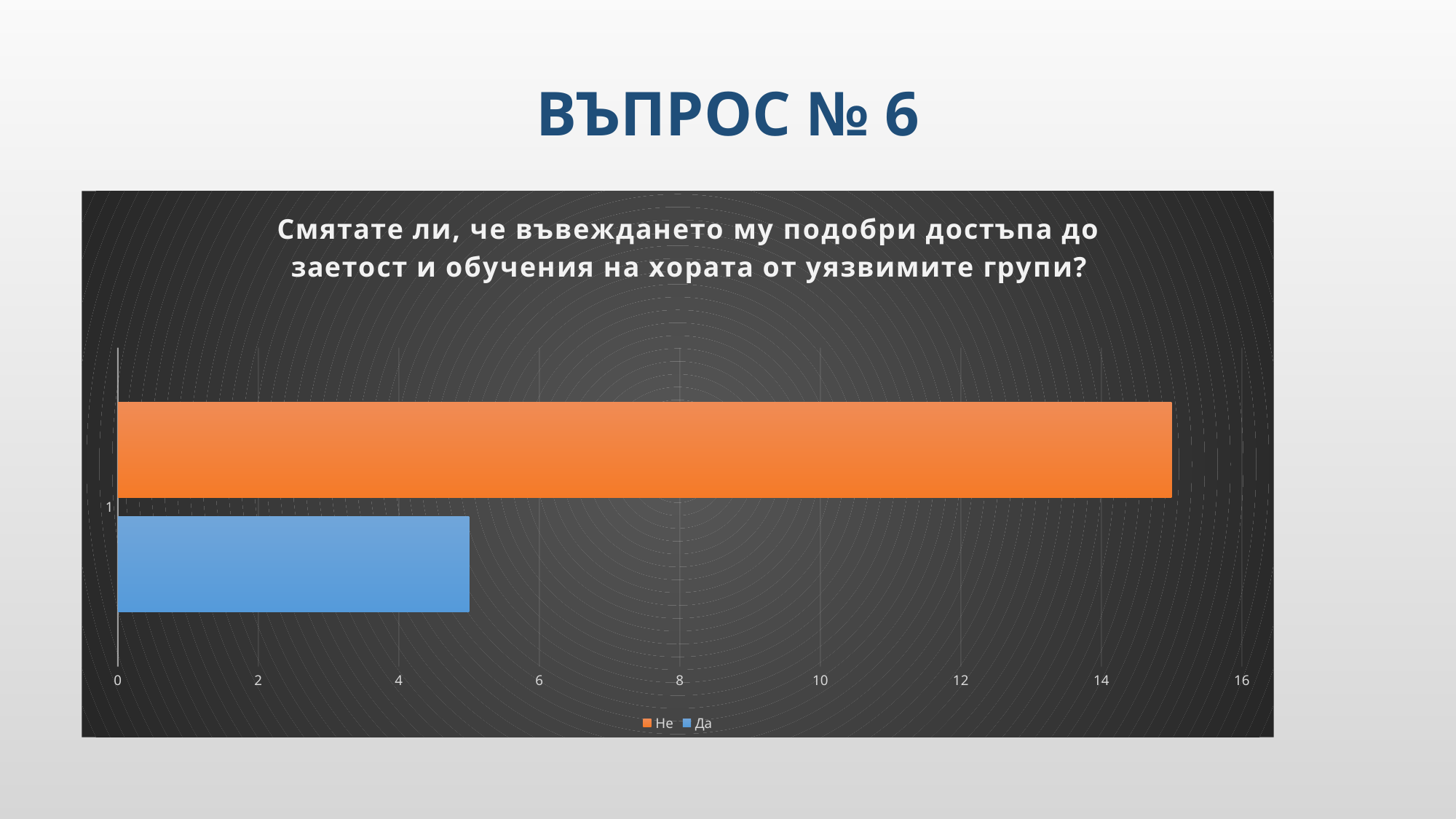
Which series has the lowest value? Да Which series has the longer bar, Не or Да? Не Is the value for Не greater or less than 14? greater What colour is the bar for the series Да? blue Is the value for Да greater or less than 4? greater Which series has the highest value? Не What kind of chart is shown on the slide? bar chart How many series does the legend list? 2 Is the value for Не greater or less than 16? less What is the highest value shown on the horizontal axis? 16 How many categories are shown on the vertical axis? 1